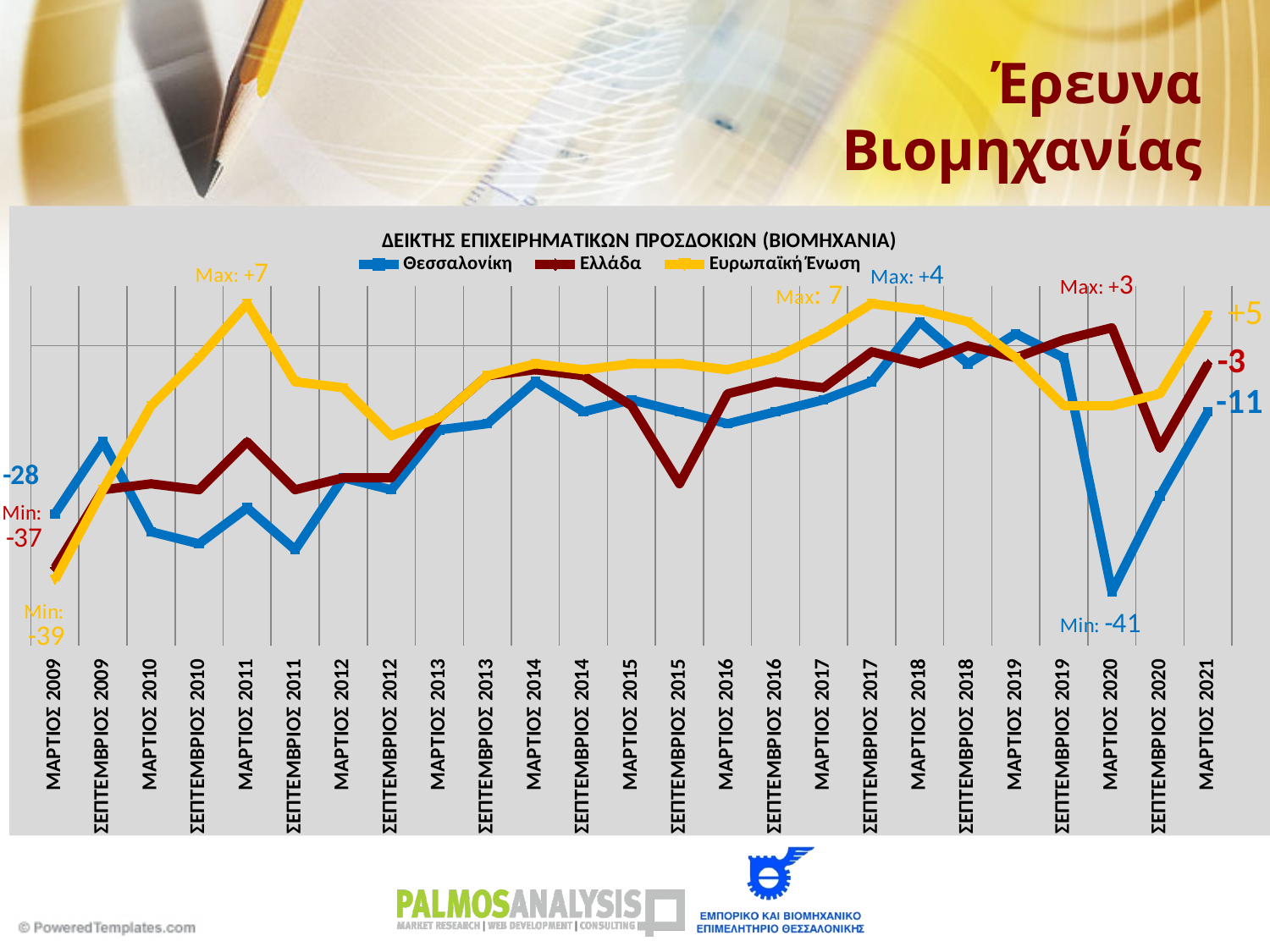
How many series does the legend list? 3 What is the maximum value labelled for the Ελλάδα series? +3 What is the difference between the Ευρωπαϊκή Ένωση value and the Θεσσαλονίκη value in ΜΑΡΤΙΟΣ 2021? 16 What is the minimum value labelled for the Ευρωπαϊκή Ένωση series? -39 What type of chart is shown on the slide? line chart What is the value for Ευρωπαϊκή Ένωση in ΜΑΡΤΙΟΣ 2021? +5 What is the minimum value labelled for the Θεσσαλονίκη series, and in which period does it occur? -41, ΜΑΡΤΙΟΣ 2020 What is the value for Θεσσαλονίκη in ΜΑΡΤΙΟΣ 2009? -28 What is the value for Ελλάδα in ΜΑΡΤΙΟΣ 2021? -3 How many time periods are shown on the x axis? 25 What is the value for Θεσσαλονίκη in ΜΑΡΤΙΟΣ 2021? -11 In ΜΑΡΤΙΟΣ 2021, which series has the higher value: Ελλάδα or Ευρωπαϊκή Ένωση? Ευρωπαϊκή Ένωση